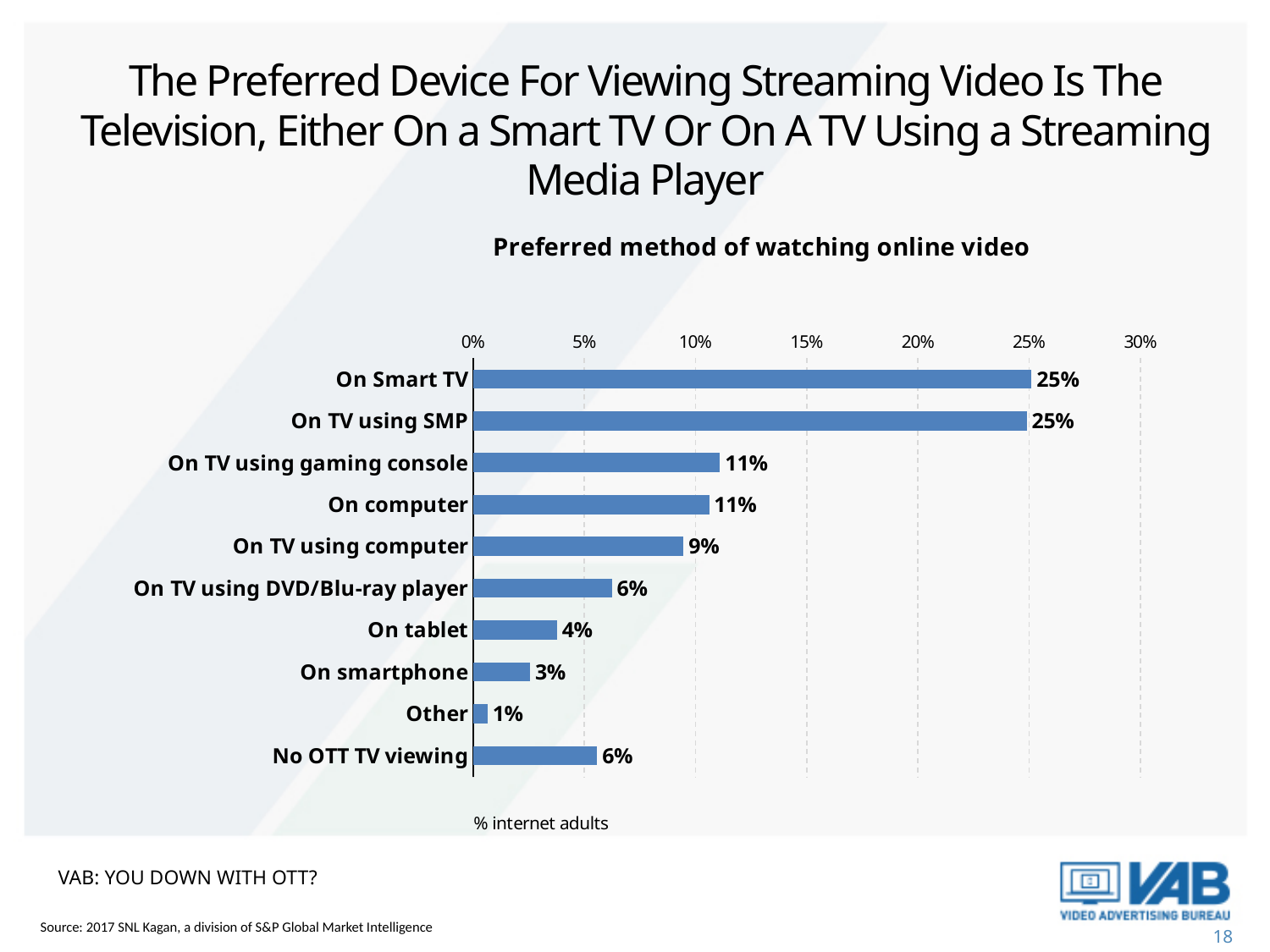
What is the value for On smartphone? 3% Which category has the lowest value? Other What is the value for On TV using gaming console? 11% Which is larger, On tablet or On smartphone? On tablet What kind of chart is shown on the slide? Bar chart Which is larger, On computer or On TV using computer? On computer How many categories are shown in the chart? 10 What is the difference between On Smart TV and On TV using DVD/Blu-ray player? 19% What is the value for On Smart TV? 25% What is the title of the chart? Preferred method of watching online video What is the difference between On TV using computer and On tablet? 5% What is the value for No OTT TV viewing? 6%